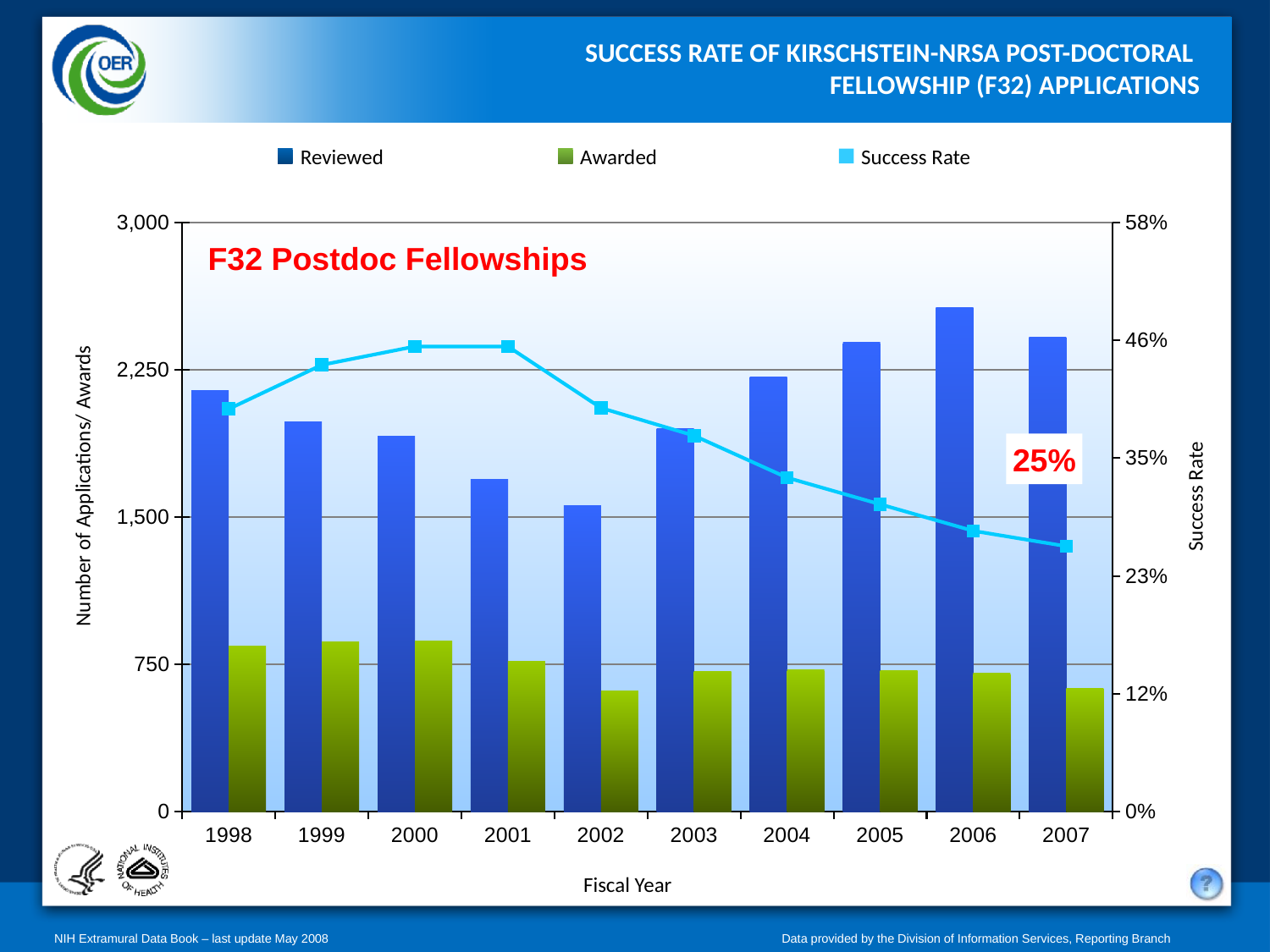
Which fiscal year has the lowest success rate? 2007 How many series does the legend list? 3 What is the title of the x axis? Fiscal Year Does the success rate rise or fall from 2001 to 2007? Fall Is the Awarded value for 2002 greater or less than 750? less Which fiscal year has the highest number of Reviewed applications? 2006 Is the Reviewed value for 2006 greater or less than 2,250? greater Which is larger, the Reviewed value for 2005 or for 2003? 2005 How many fiscal years are shown on the x axis? 10 Which fiscal year has the lowest number of Reviewed applications? 2002 What kind of chart is shown on the slide? A bar chart combined with a line What is the success rate for fiscal year 2007? 25%